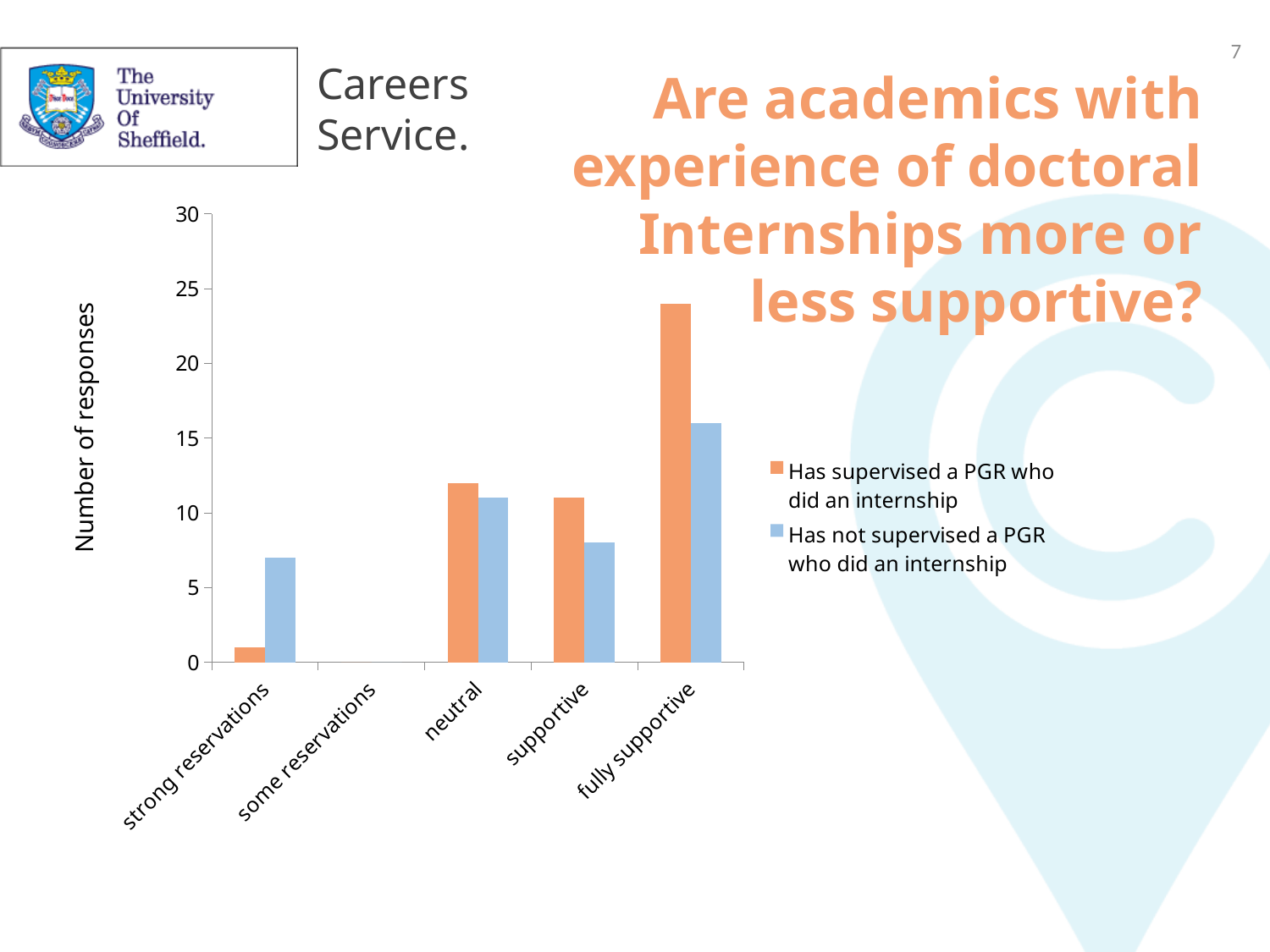
How many categories are shown on the x axis? 5 For 'strong reservations', which series has the larger value? Has not supervised a PGR who did an internship Is the value for 'fully supportive' in the 'Has supervised a PGR who did an internship' series greater or less than 20? greater Which category has the highest value for 'Has supervised a PGR who did an internship'? fully supportive Which category has the highest value for 'Has not supervised a PGR who did an internship'? fully supportive How many series does the legend list? 2 Is the value for 'strong reservations' in the 'Has not supervised a PGR who did an internship' series greater or less than 5? greater For 'fully supportive', which series has the larger value? Has supervised a PGR who did an internship What kind of chart is shown on the slide? bar chart Is the value for 'strong reservations' in the 'Has supervised a PGR who did an internship' series greater or less than 5? less What is the label of the y axis? Number of responses